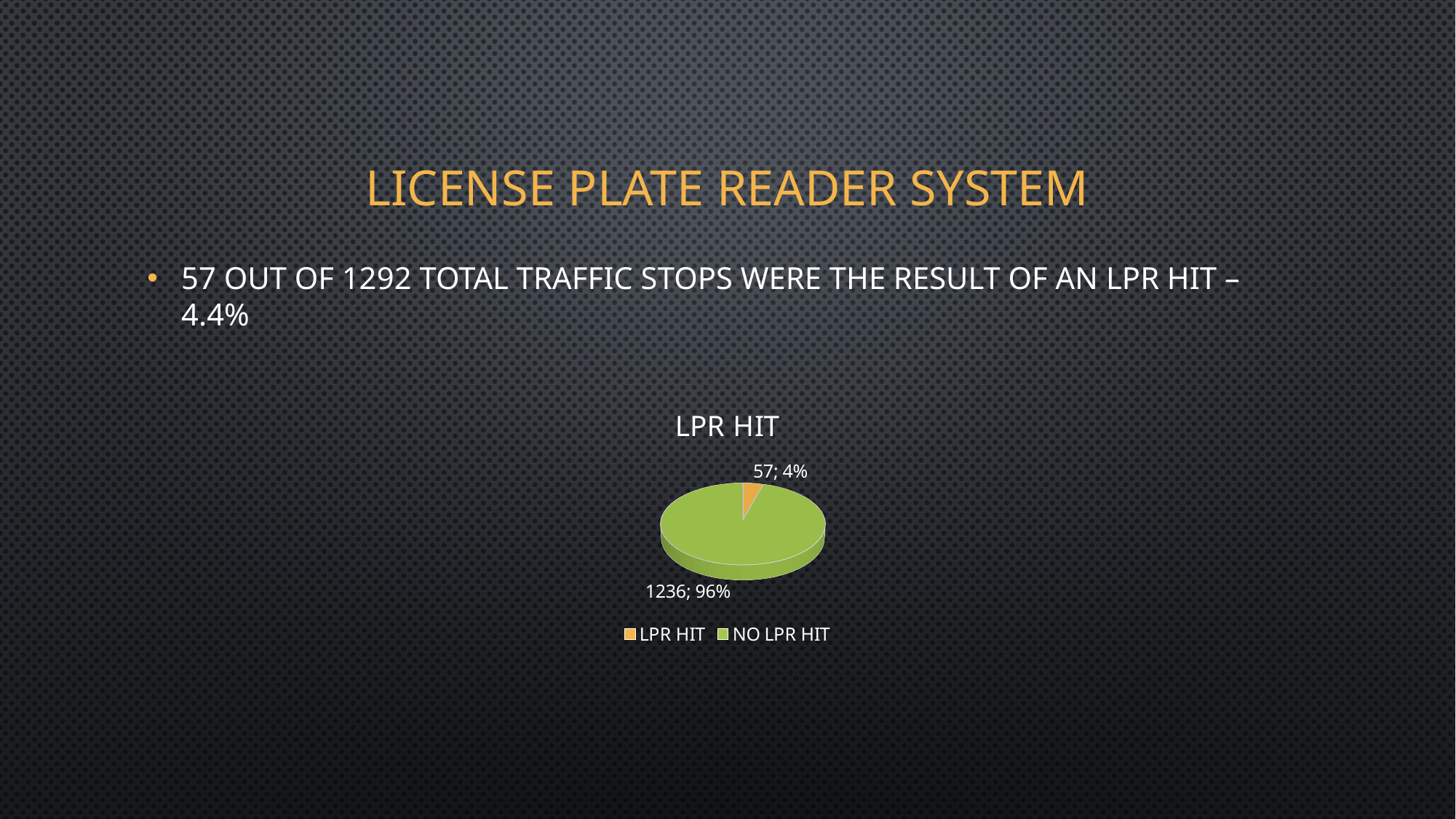
What kind of chart is shown on the slide? pie chart What is the value for LPR HIT in the pie chart? 57 How many slices does the pie chart have? 2 What is the difference between the NO LPR HIT value and the LPR HIT value? 1179 Which category has the smallest slice in the pie chart? LPR HIT What share of the pie does the NO LPR HIT slice represent? 96% What is the title of the chart? LPR HIT Which colour represents LPR HIT in the pie chart? orange What share of the pie does the LPR HIT slice represent? 4% How many entries does the chart legend list? 2 What is the value for NO LPR HIT in the pie chart? 1236 Which category has the largest slice in the pie chart? NO LPR HIT